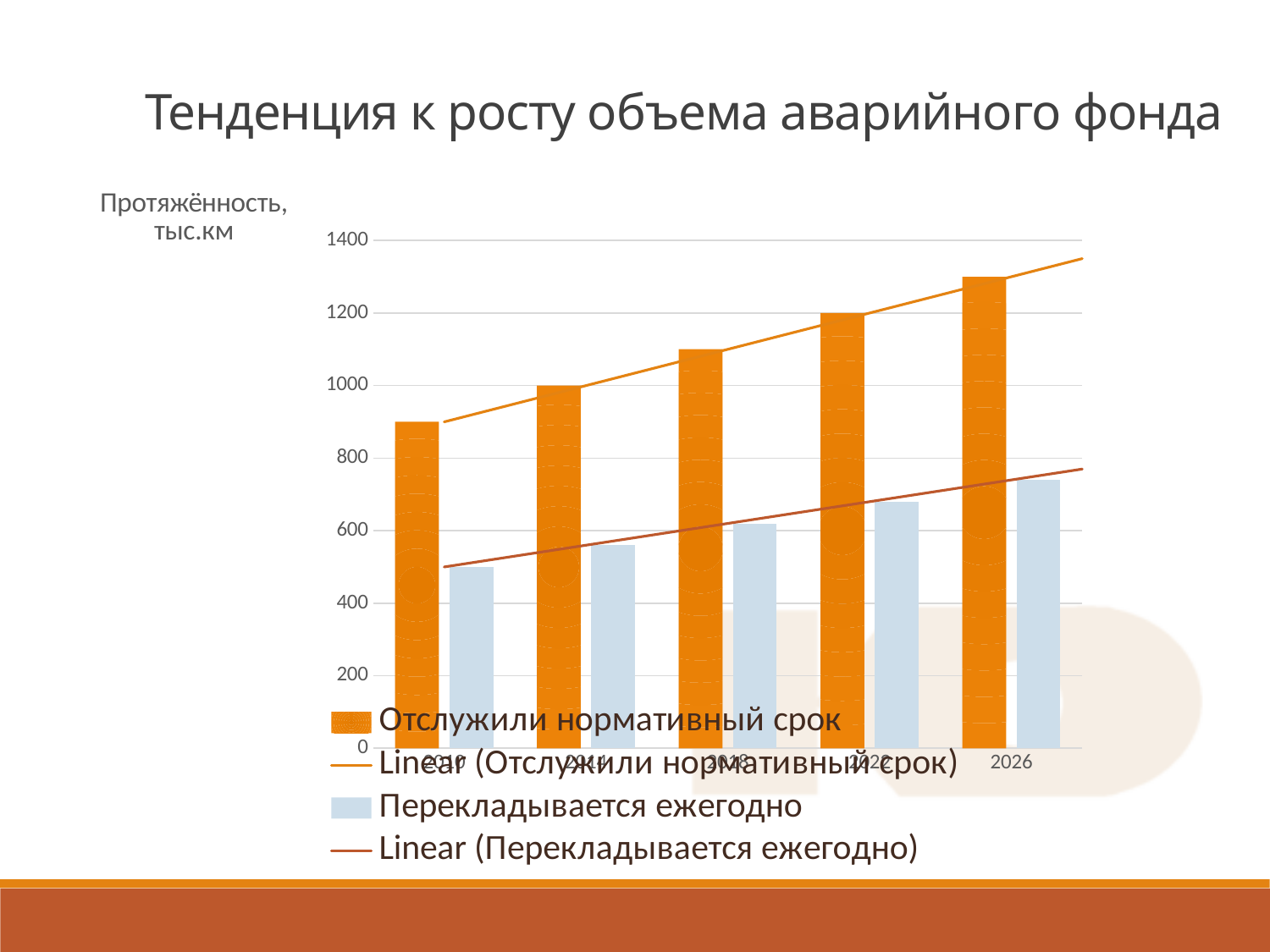
Is the value for 'Отслужили нормативный срок' in 2026 greater or less than 1200? greater Do the values for 'Перекладывается ежегодно' rise or fall from left to right along the x axis? rise Which year has the highest value for 'Отслужили нормативный срок'? 2026 What kind of chart is shown on the slide? bar chart Do the values for 'Отслужили нормативный срок' rise or fall from left to right along the x axis? rise Is the value for 'Перекладывается ежегодно' in 2026 greater or less than 600? greater What unit label is shown for the vertical axis of the chart? Протяжённость, тыс.км How many years (categories) are plotted along the x axis? 5 Is the value for 'Перекладывается ежегодно' in 2026 greater or less than 800? less What is the title of the slide containing the chart? Тенденция к росту объема аварийного фонда In 2026, which series has the larger value: 'Отслужили нормативный срок' or 'Перекладывается ежегодно'? Отслужили нормативный срок How many entries does the chart legend list? 4